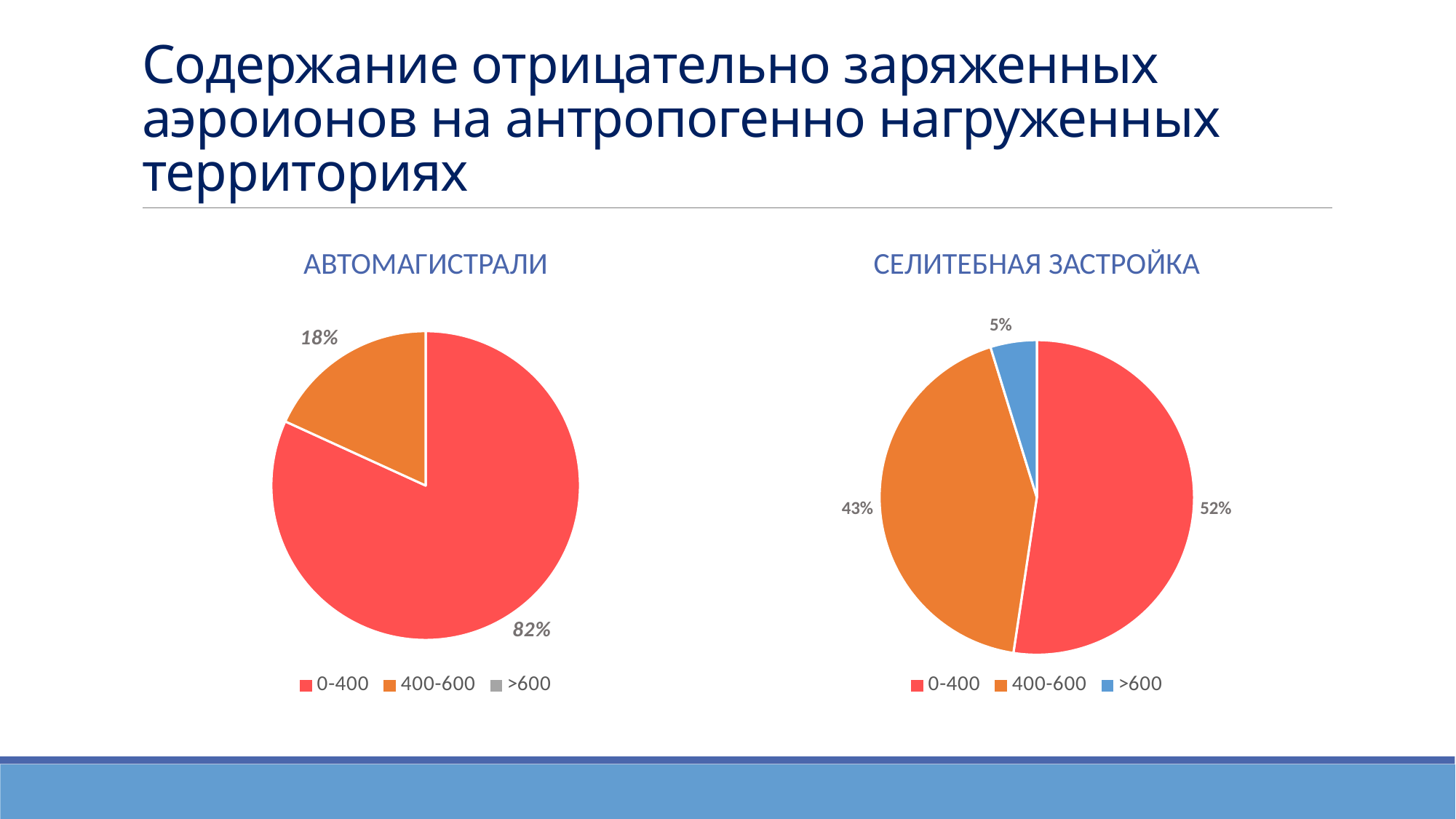
In the СЕЛИТЕБНАЯ ЗАСТРОЙКА chart, which category has the smallest slice? >600 How many entries does the legend of the АВТОМАГИСТРАЛИ chart list? 3 In the СЕЛИТЕБНАЯ ЗАСТРОЙКА chart, what share does the 0-400 slice have? 52% In the СЕЛИТЕБНАЯ ЗАСТРОЙКА chart, what is the difference between the 0-400 and 400-600 shares? 9% In the АВТОМАГИСТРАЛИ chart, what share does the 0-400 slice have? 82% In the АВТОМАГИСТРАЛИ chart, which category has the largest slice? 0-400 What type of chart is the СЕЛИТЕБНАЯ ЗАСТРОЙКА chart? Pie chart In the АВТОМАГИСТРАЛИ chart, what share does the 400-600 slice have? 18% In the АВТОМАГИСТРАЛИ chart, what is the difference between the 0-400 and 400-600 shares? 64% Which chart has the larger 0-400 share, АВТОМАГИСТРАЛИ or СЕЛИТЕБНАЯ ЗАСТРОЙКА? АВТОМАГИСТРАЛИ